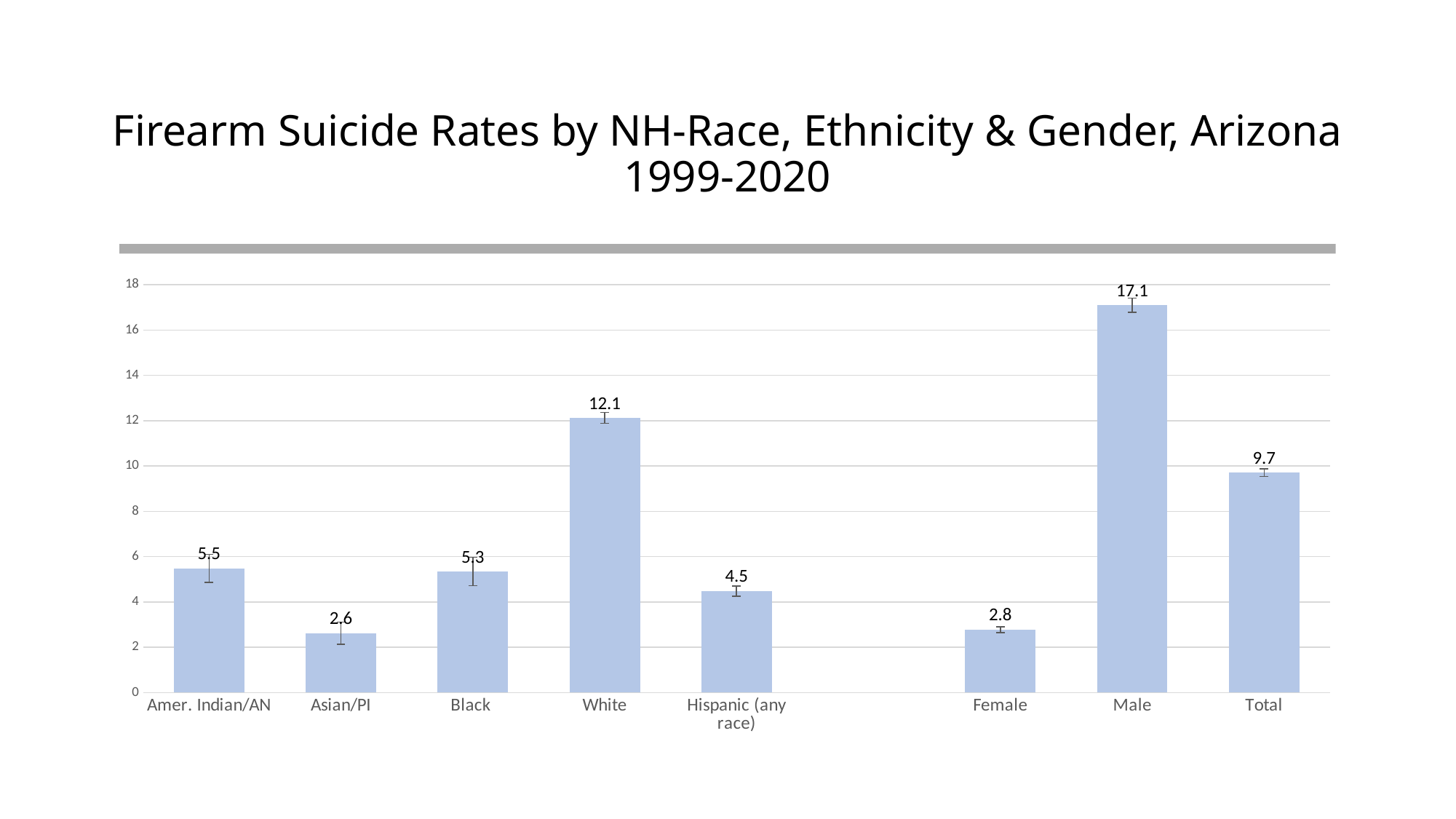
What is the firearm suicide rate for Hispanic (any race)? 4.5 What is the firearm suicide rate for Asian/PI? 2.6 Which category has the lowest firearm suicide rate? Asian/PI Is the value for Total greater or less than 8? greater Which category has the highest firearm suicide rate? Male How many bars are shown in the chart? 8 What is the difference between the White and Black firearm suicide rates? 6.8 What kind of chart is shown on the slide? Bar chart What is the firearm suicide rate for Male? 17.1 What is the difference between the Male and Female firearm suicide rates? 14.3 What is the firearm suicide rate for White? 12.1 Which has a higher firearm suicide rate, Amer. Indian/AN or Hispanic (any race)? Amer. Indian/AN